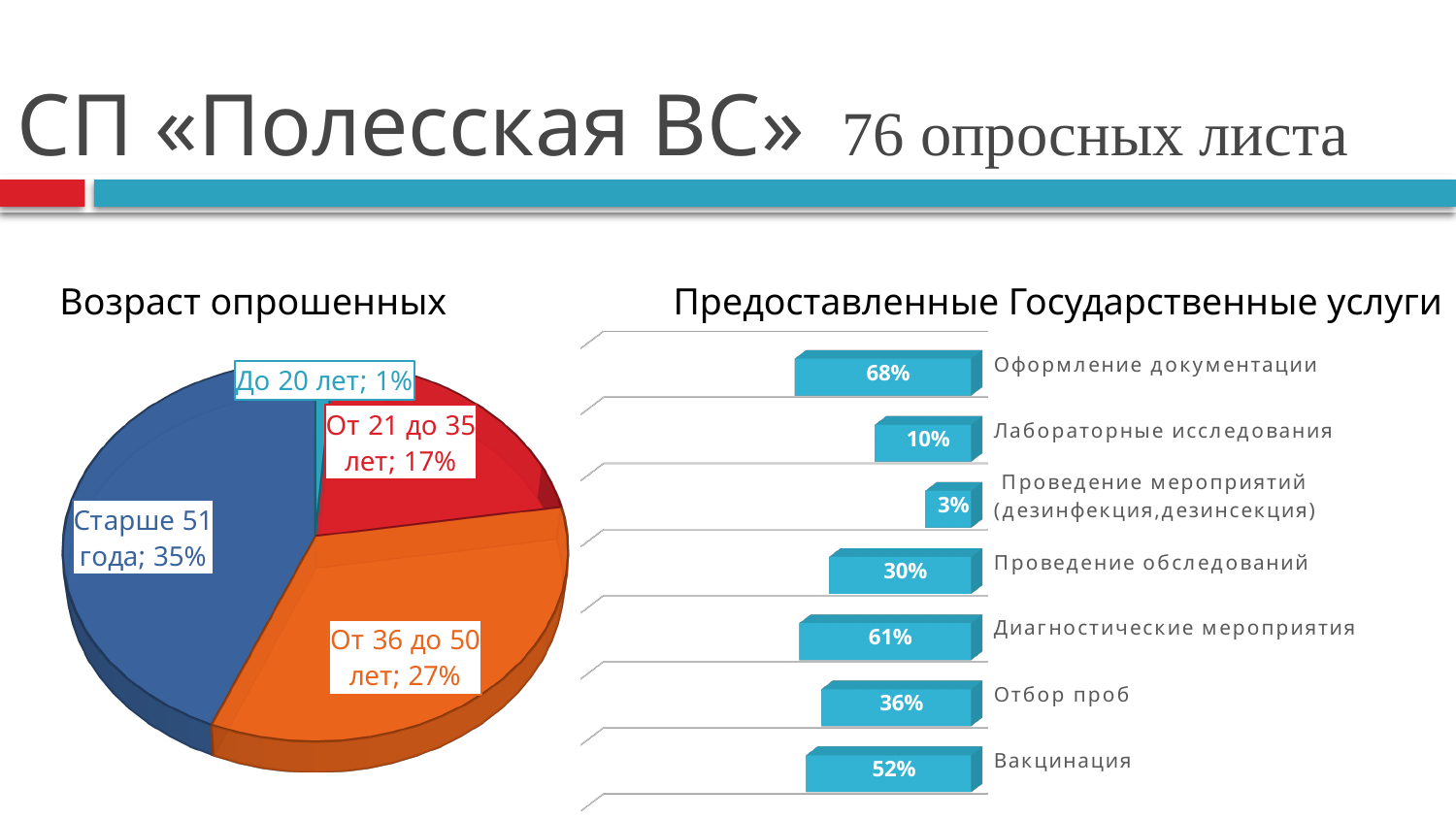
In the chart 'Возраст опрошенных', which age group has the largest share? Старше 51 года In the chart 'Возраст опрошенных', what share of respondents are 'От 21 до 35 лет'? 17% In the chart 'Предоставленные Государственные услуги', what is the value for 'Лабораторные исследования'? 10% In the chart 'Возраст опрошенных', which age group has the smallest share? До 20 лет In the chart 'Возраст опрошенных', how many age groups are shown? 4 In the chart 'Возраст опрошенных', what share of respondents are 'Старше 51 года'? 35% In the chart 'Предоставленные Государственные услуги', what is the value for 'Вакцинация'? 52% In the chart 'Предоставленные Государственные услуги', what is the difference between 'Оформление документации' and 'Диагностические мероприятия'? 7% What type of chart is 'Возраст опрошенных'? Pie chart In the chart 'Предоставленные Государственные услуги', which service has the lowest value? Проведение мероприятий (дезинфекция,дезинсекция) In the chart 'Предоставленные Государственные услуги', which is larger: 'Отбор проб' or 'Проведение обследований'? Отбор проб In the chart 'Предоставленные Государственные услуги', which service has the highest value? Оформление документации